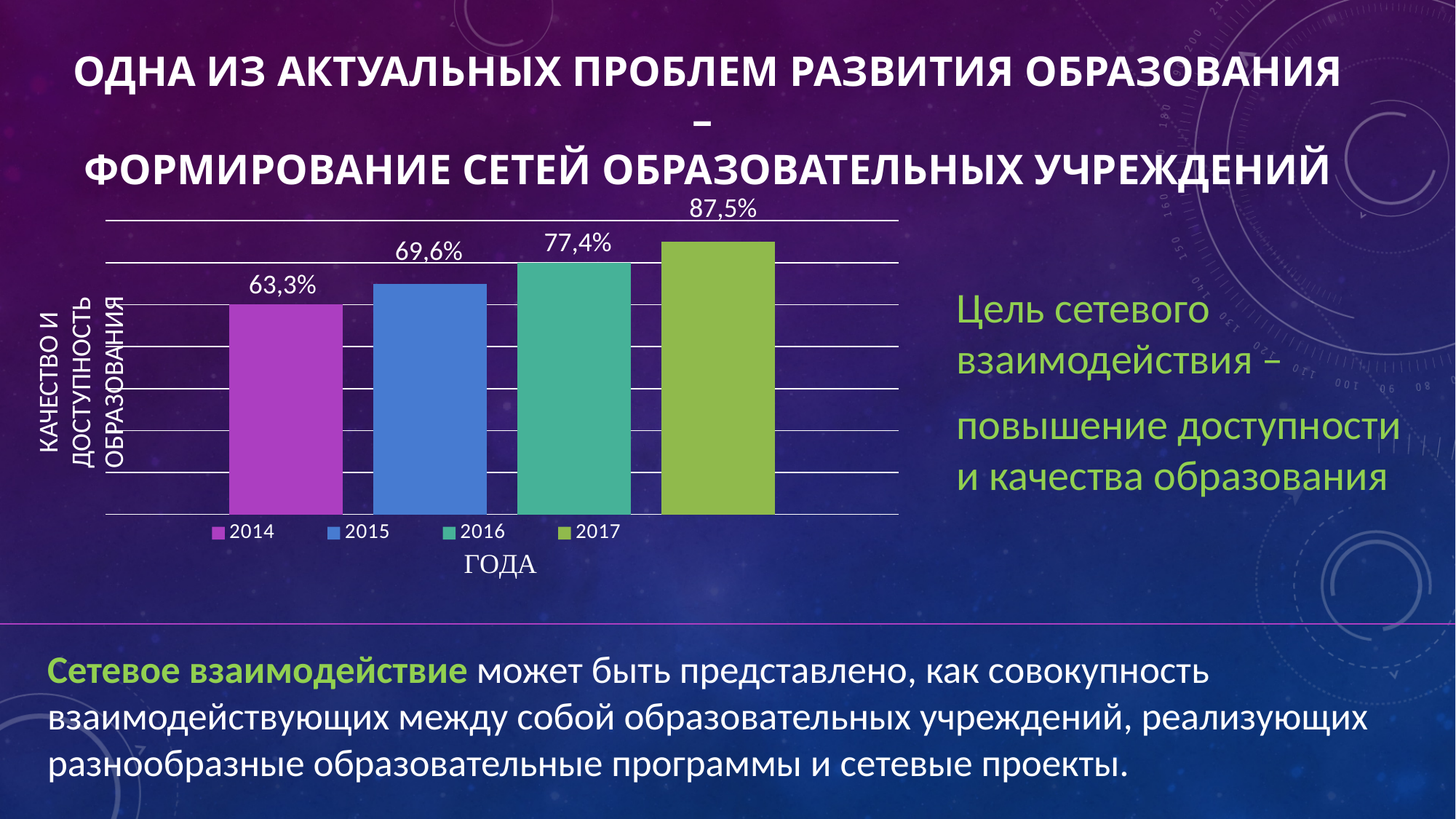
Which year has the highest value? 2017 How many bars are plotted in the chart? 4 What is the value shown for 2017? 87,5% Which year has the lowest value? 2014 What is the difference between the values for 2016 and 2015? 7,8% Which is larger, the value for 2015 or the value for 2016? 2016 What is the value shown for 2016? 77,4% What is the value shown for 2015? 69,6% Do the values rise or fall from 2014 to 2017? Rise What is the value shown for 2014? 63,3% What kind of chart is shown on the slide? Bar chart What is the difference between the values for 2017 and 2014? 24,2%